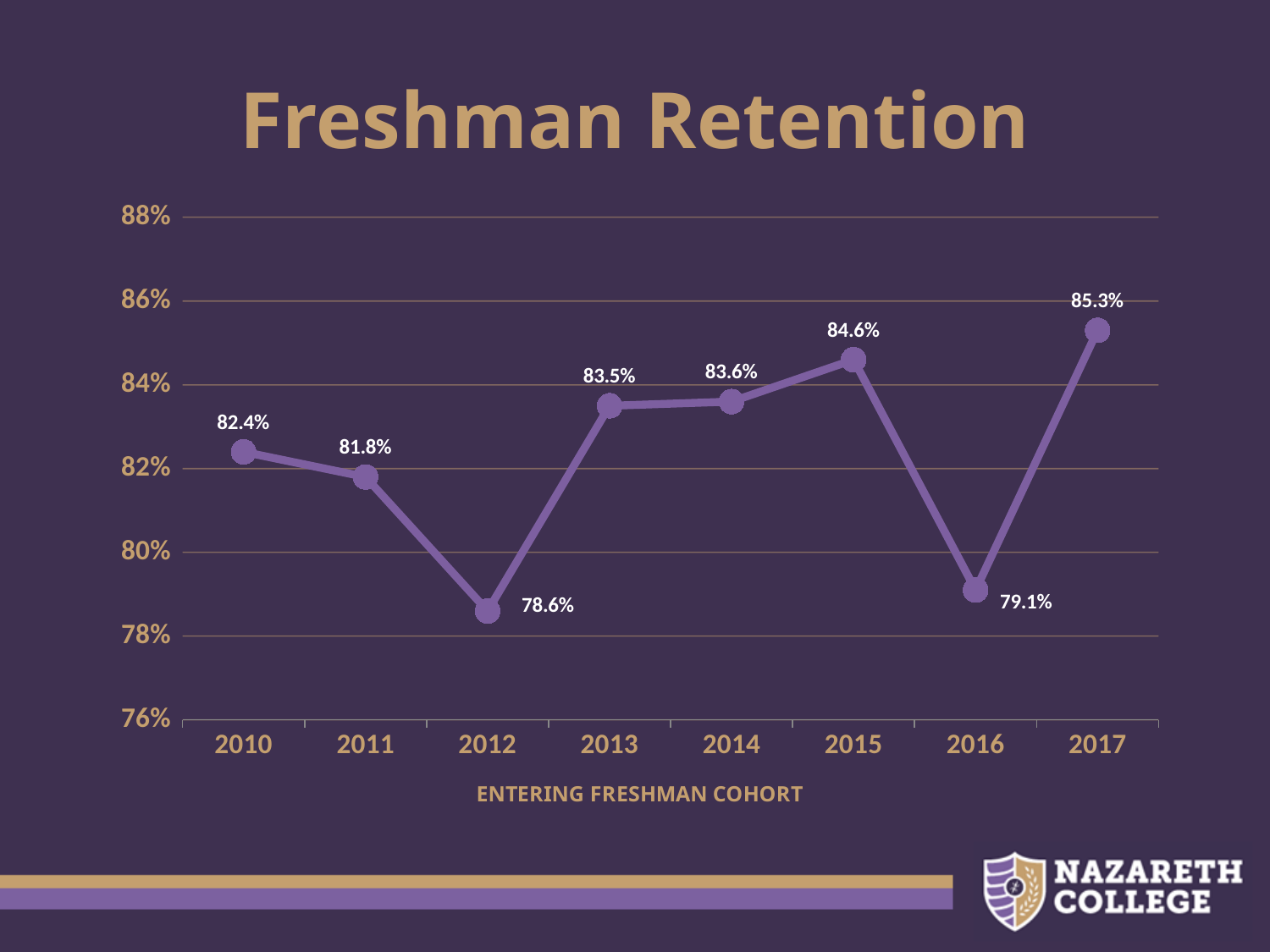
What is the freshman retention rate for the 2015 entering cohort? 84.6% Which entering cohort has the lowest freshman retention rate? 2012 What is the difference in retention rate between the 2010 and 2011 cohorts? 0.6% What is the freshman retention rate for the 2012 entering cohort? 78.6% Which entering cohort has the highest freshman retention rate? 2017 What is the title of the chart? Freshman Retention What is the freshman retention rate for the 2010 entering cohort? 82.4% Is the retention rate for the 2016 cohort greater or less than 80%? less What is the difference in retention rate between the 2017 and 2016 cohorts? 6.2% What kind of chart is shown on the slide? line chart How many entering freshman cohorts are plotted on the chart? 8 Which cohort has a higher retention rate, 2013 or 2016? 2013